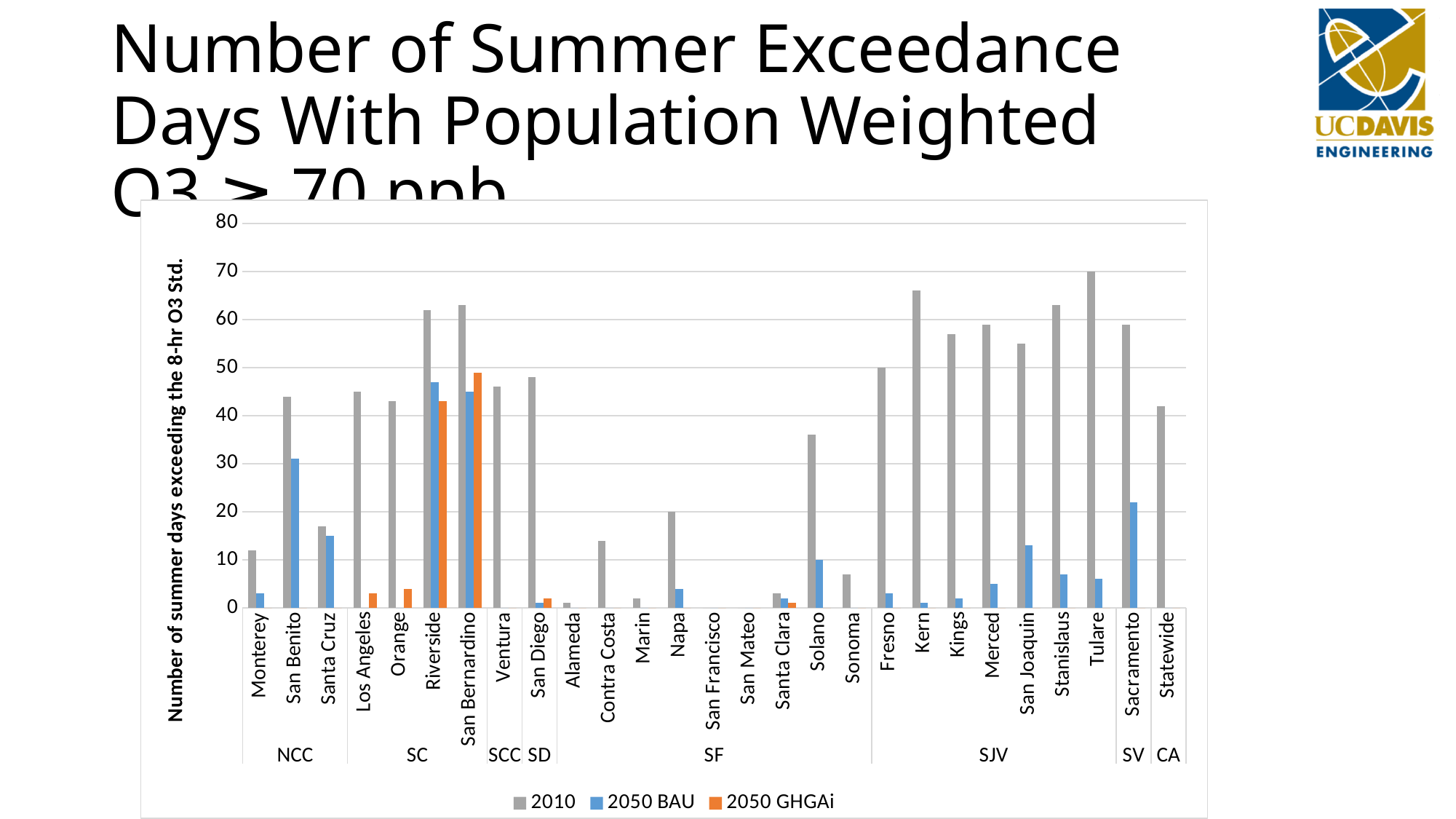
Is the 2050 BAU value for Sacramento greater or less than 30? less Which series is shown in orange in the legend? 2050 GHGAi Which category has the highest 2050 GHGAi value? San Bernardino How many counties/regions are listed along the x axis? 27 What kind of chart is shown on the slide? bar chart Which is larger, the 2050 BAU value for Sacramento or the 2050 BAU value for Solano? Sacramento How many series does the legend list? 3 Is the 2010 value for Tulare greater or less than 60? greater Which category has the highest 2010 value? Tulare Is the 2010 value for Solano greater or less than 30? greater Which is larger, the 2010 value for Kern or the 2010 value for Kings? Kern